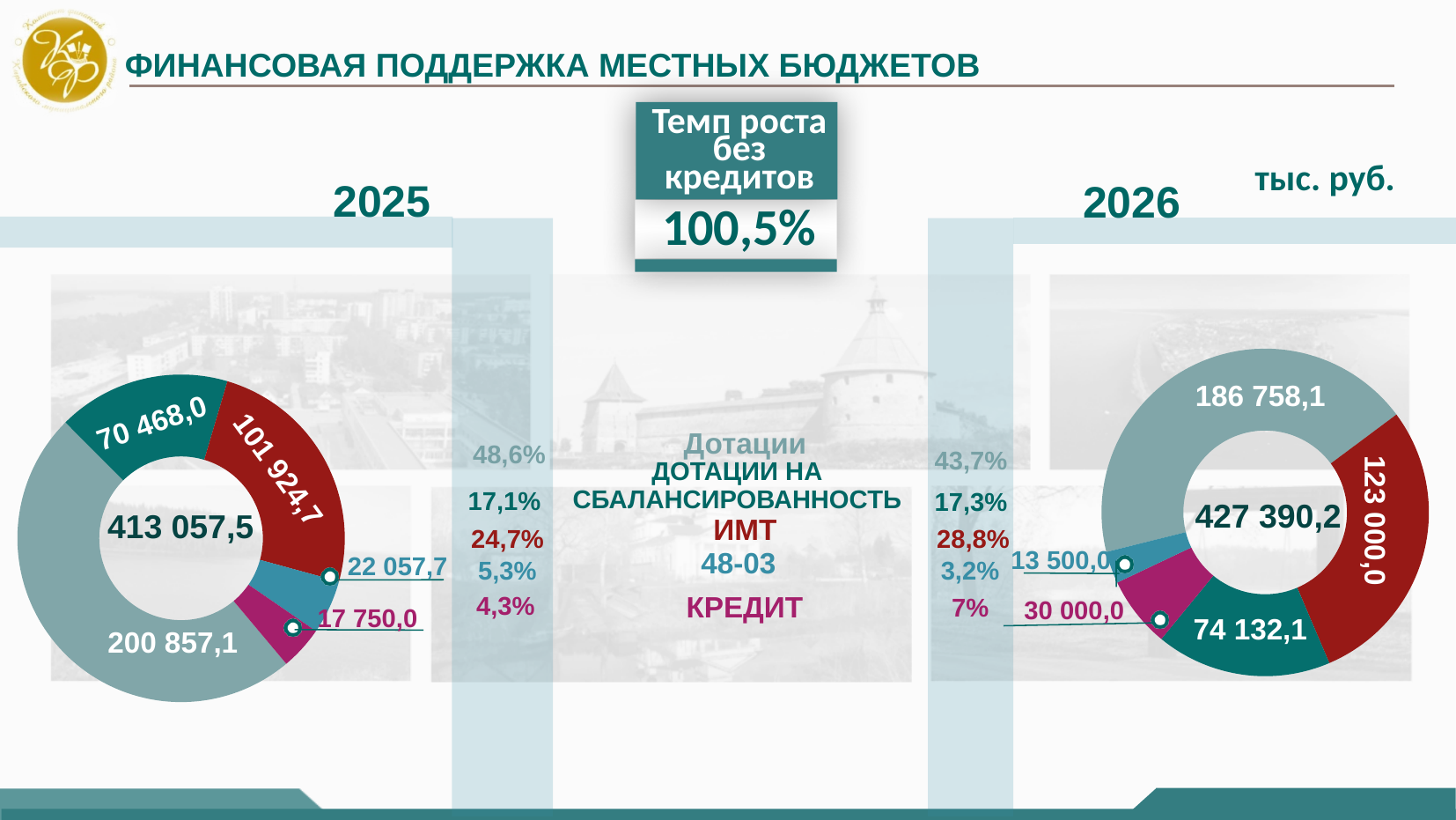
What share of the 2026 chart does ИМТ represent? 28,8% In the 2026 chart, what is the value for ИМТ? 123 000,0 What share of the 2025 chart does Дотации represent? 48,6% In the 2025 chart, what is the value for Дотации? 200 857,1 In the 2026 chart, what is the value for 48-03? 13 500,0 Which is larger: the value for ИМТ in 2025 or in 2026? 2026 In the 2025 chart, which category has the largest value? Дотации What type of chart is used to show the 2025 budget support breakdown? Donut (pie) chart How many categories does each donut chart contain? 5 In the 2026 chart, which category has the smallest value? 48-03 In the 2025 chart, what is the value for КРЕДИТ? 17 750,0 What is the total shown in the centre of the 2026 chart? 427 390,2